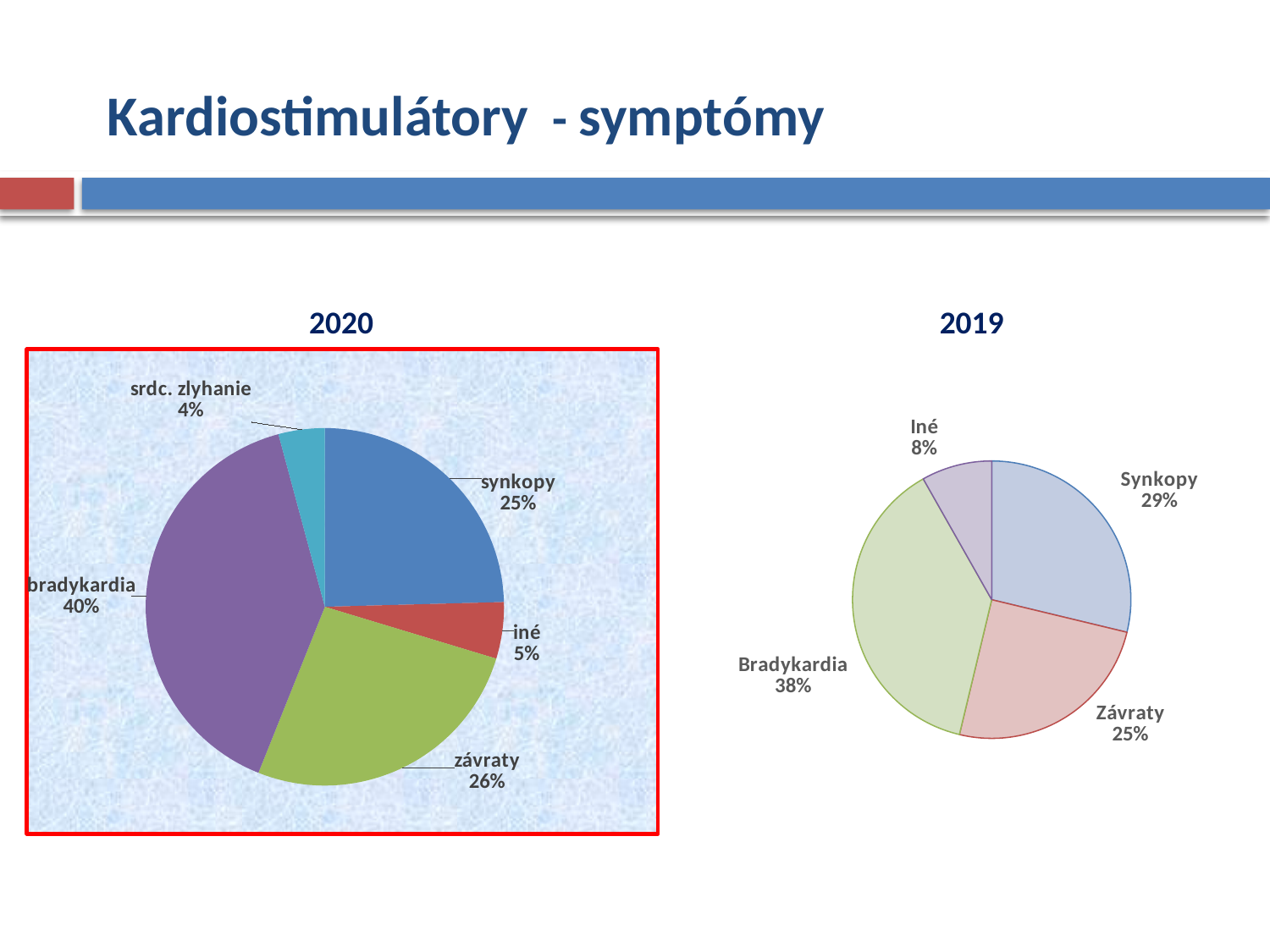
In the 2019 pie chart, which is larger, Synkopy or Závraty? Synkopy In the 2019 pie chart, what share does Synkopy have? 29% In the 2020 pie chart, what is the difference between the shares of bradykardia and synkopy? 15% What kind of chart is the 2019 chart? Pie chart In the 2020 pie chart, which category has the largest share? bradykardia In the 2019 pie chart, which category has the largest share? Bradykardia In the 2019 pie chart, what share does Iné have? 8% In the 2019 pie chart, which category has the smallest share? Iné In the 2020 pie chart, which category has the smallest share? srdc. zlyhanie In the 2020 pie chart, what share does srdc. zlyhanie have? 4% How many categories does the 2020 pie chart show? 5 In the 2020 pie chart, what share does bradykardia have? 40%